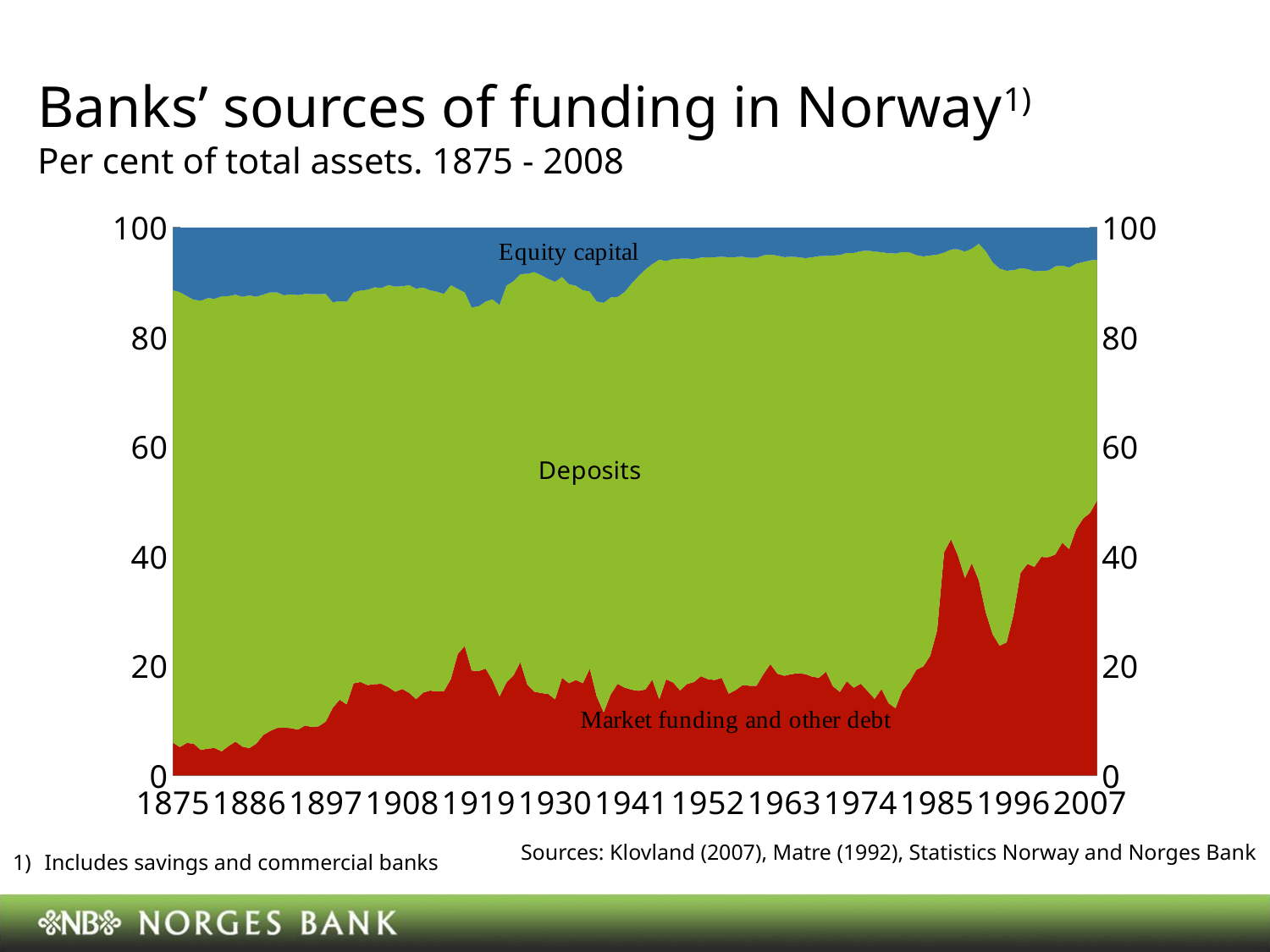
Does the share of Equity capital rise or fall from 1875 to 2007? fall Is the value for Equity capital in 2007 greater or less than 20? less Is the share of Market funding and other debt larger in 1875 or in 2007? 2007 Which funding source accounts for the smallest share of total assets in 2007? Equity capital Does the share of Market funding and other debt rise or fall from 1875 to 2007? rise Which funding source is shown in blue at the top of the chart? Equity capital What kind of chart is shown on the slide? Stacked area chart Is the value for Market funding and other debt in 1875 greater or less than 20? less Which funding source is shown in red at the bottom of the chart? Market funding and other debt Which funding source accounts for the largest share of total assets in 1875? Deposits How many funding sources (series) are shown in the chart? 3 Is the value for Market funding and other debt in 2007 greater or less than 40? greater